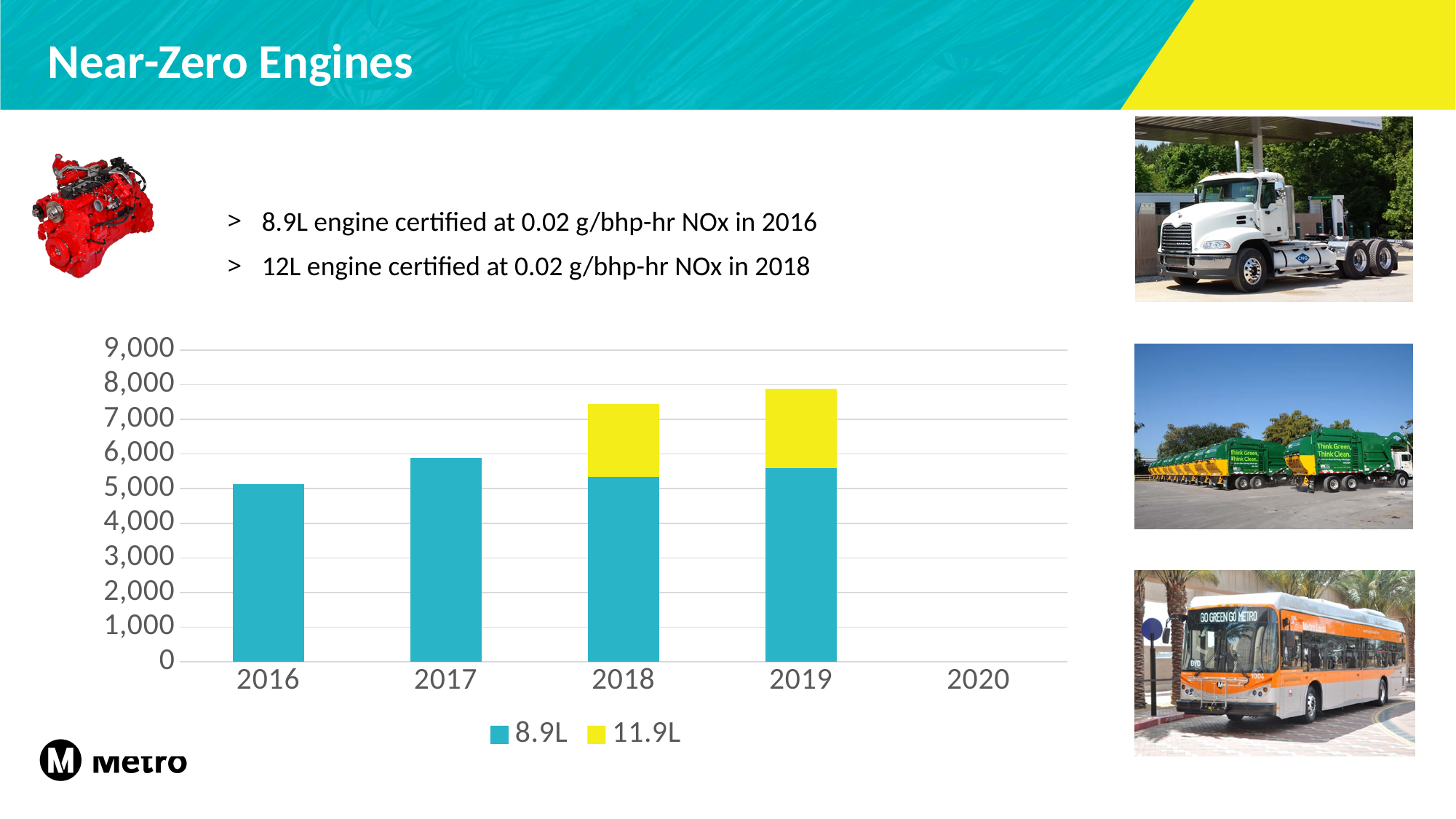
Is the 8.9L value for 2016 greater or less than 6,000? less Which year on the x axis has no bar plotted? 2020 How many years are shown on the x axis of the chart? 5 Which two series are listed in the chart legend? 8.9L and 11.9L Is the 8.9L value for 2017 greater or less than 5,000? greater Do the total bar heights rise or fall from 2016 to 2019? Rise How many series does the chart legend list? 2 Is the total stacked bar for 2019 greater or less than 7,000? greater Which year has the shortest bar in the chart? 2016 What kind of chart is shown on the slide? Stacked bar chart Which year has the tallest stacked bar in the chart? 2019